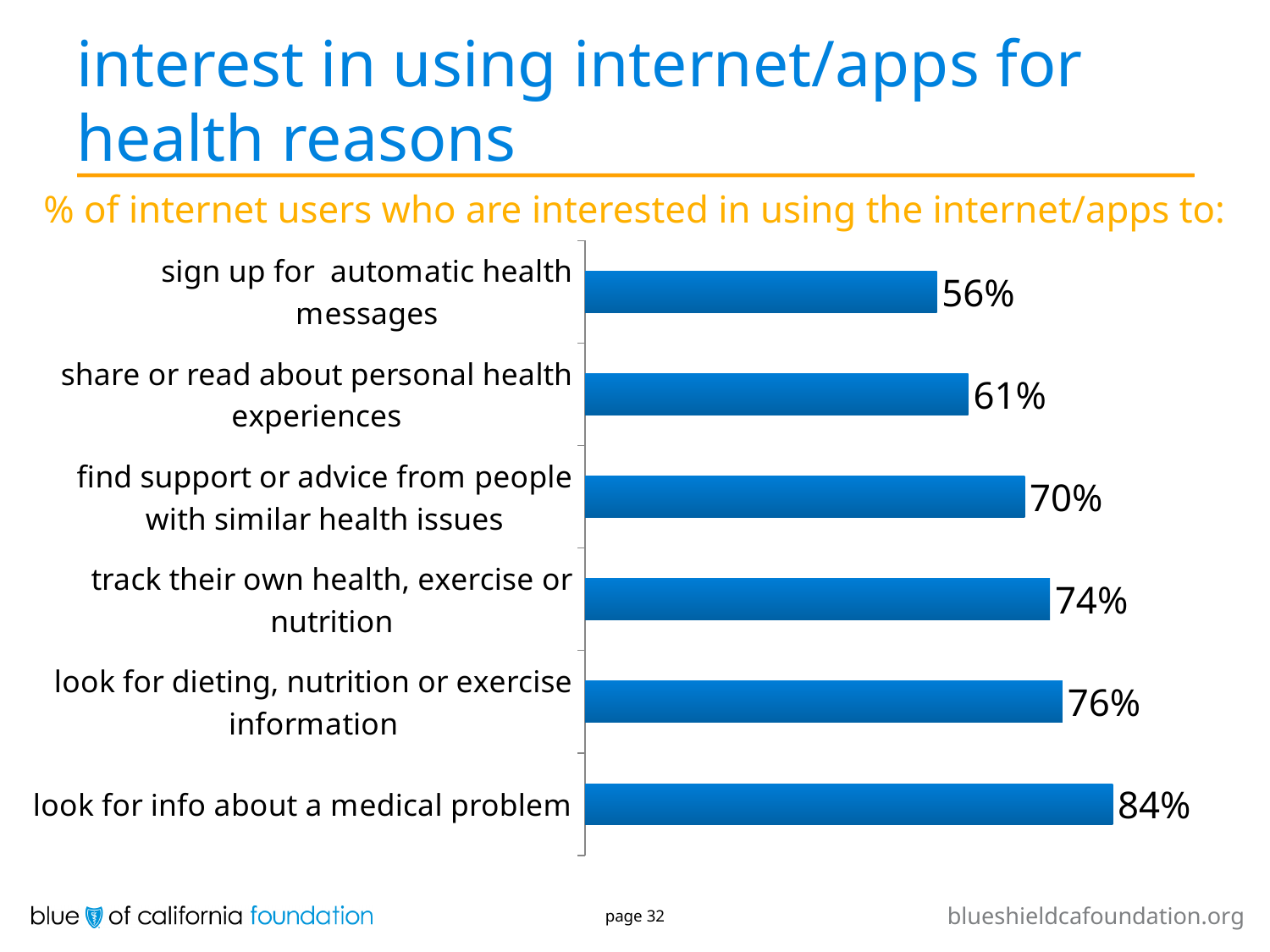
What percentage of internet users are interested in using the internet/apps to find support or advice from people with similar health issues? 70% What percentage of internet users are interested in using the internet/apps to look for info about a medical problem? 84% What is the difference in percentage points between looking for info about a medical problem and signing up for automatic health messages? 28 percentage points What percentage of internet users are interested in using the internet/apps to track their own health, exercise or nutrition? 74% Which has a larger share of interested users: tracking their own health, exercise or nutrition, or finding support or advice from people with similar health issues? track their own health, exercise or nutrition What is the subtitle shown above the chart? % of internet users who are interested in using the internet/apps to: What is the difference in percentage points between looking for dieting, nutrition or exercise information and sharing or reading about personal health experiences? 15 percentage points How many activities are shown in the chart? 6 What kind of chart is shown on the slide? bar chart Which activity has the highest share of interested internet users? look for info about a medical problem Which activity has the lowest share of interested internet users? sign up for automatic health messages What percentage of internet users are interested in using the internet/apps to sign up for automatic health messages? 56%